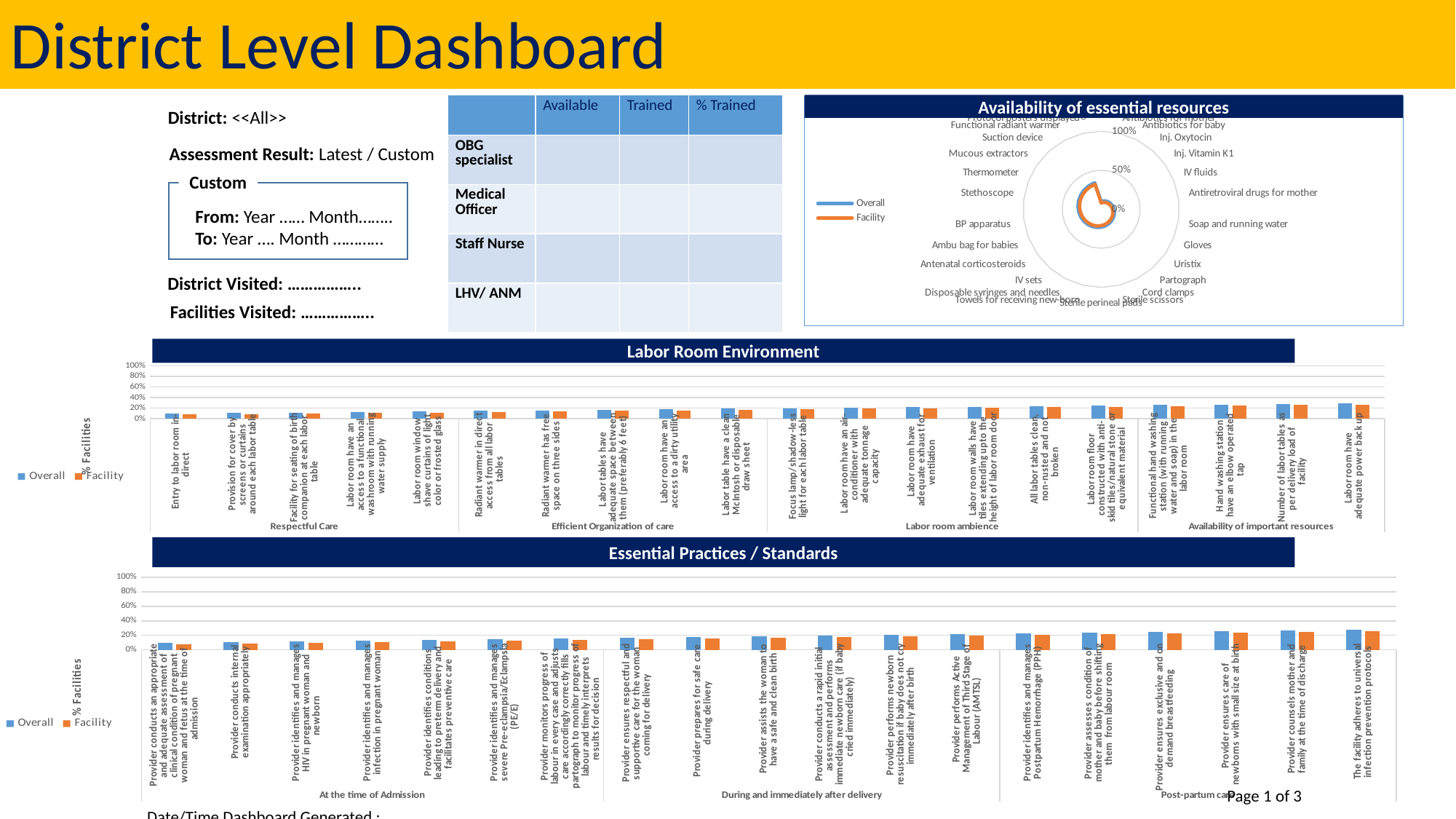
In the 'Essential Practices / Standards' chart, what is the highest value shown on the y axis? 100% In the 'Labor Room Environment' chart, is the Overall value for 'Labor room have adequate power back up' greater or less than 40%? less What kind of chart is the 'Labor Room Environment' chart? bar chart In the 'Labor Room Environment' chart, do the bar heights generally rise or fall from left to right along the x axis? rise How many series does the legend of the 'Availability of essential resources' chart list? 2 In the 'Availability of essential resources' chart, which series is drawn in orange? Facility In the 'Availability of essential resources' chart, is the Facility value for Gloves greater or less than 50%? less How many series does the legend of the 'Labor Room Environment' chart list? 2 In the 'Essential Practices / Standards' chart, is the Facility value for 'The facility adheres to universal infection prevention protocols' greater or less than 60%? less What kind of chart is the 'Essential Practices / Standards' chart? bar chart In the 'Labor Room Environment' chart, what is the label of the first category group on the x axis? Respectful Care What kind of chart is the 'Availability of essential resources' chart? radar chart